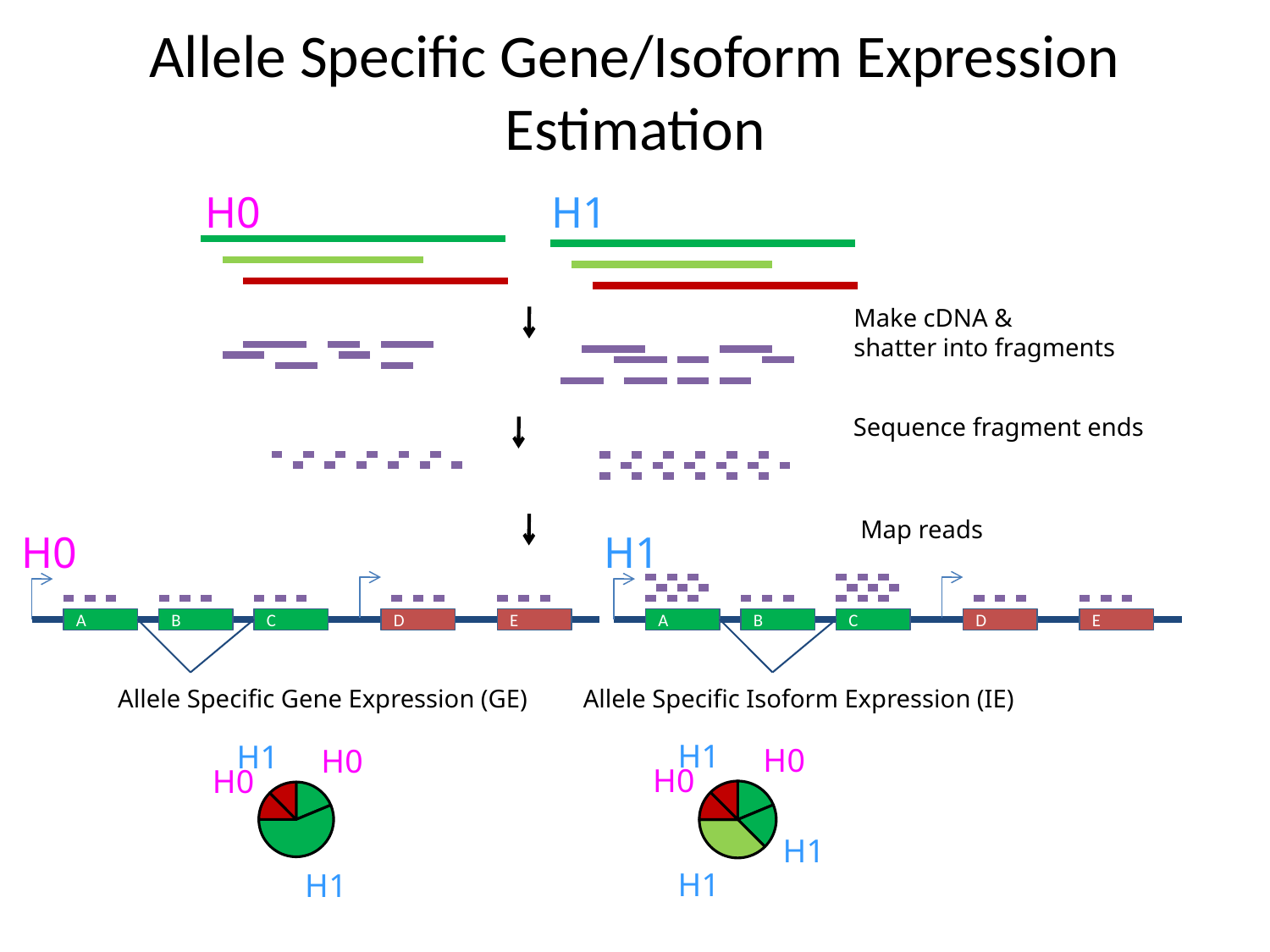
In the right pie chart (Allele Specific Isoform Expression), how many slices are labelled H1? 3 What kind of chart is shown under "Allele Specific Gene Expression (GE)"? pie chart What kind of chart is shown under "Allele Specific Isoform Expression (IE)"? pie chart In the left pie chart (Allele Specific Gene Expression), which is larger: the bottom H1 slice or the top H0 slice? the bottom H1 slice In the right pie chart (Allele Specific Isoform Expression), how many slices are labelled H0? 2 What caption appears above the left pie chart? Allele Specific Gene Expression (GE) In the left pie chart (Allele Specific Gene Expression), which label belongs to the largest slice? H1 In the left pie chart (Allele Specific Gene Expression), how many slices are there? 4 In the left pie chart (Allele Specific Gene Expression), does the largest H1 slice cover more or less than half of the pie? more What colour are the H0 slices in the two pie charts? red